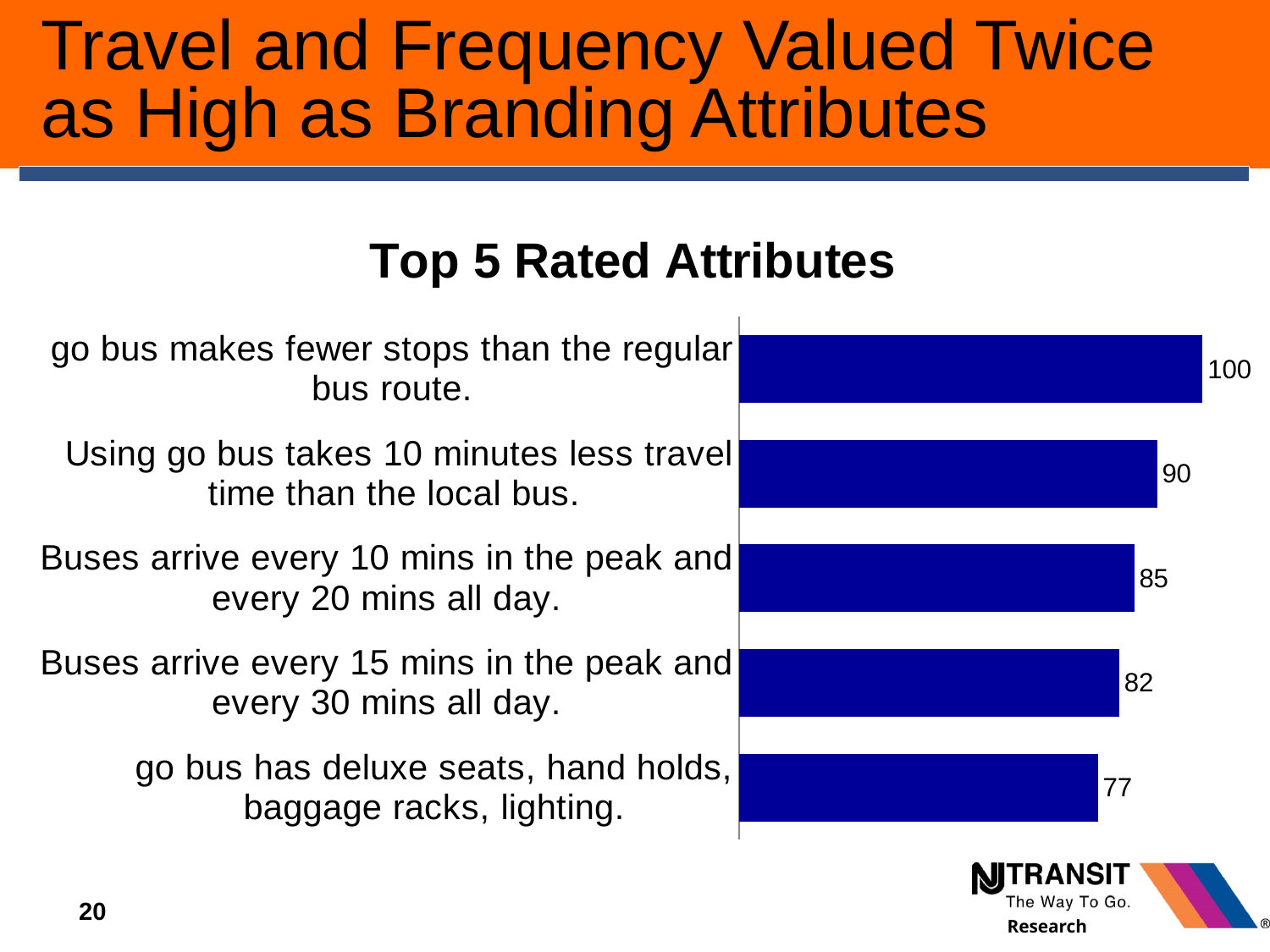
What is the value for "Using go bus takes 10 minutes less travel time than the local bus."? 90 Which attribute has the highest value? go bus makes fewer stops than the regular bus route. What is the title of the chart? Top 5 Rated Attributes What is the value for "Buses arrive every 10 mins in the peak and every 20 mins all day."? 85 What is the value for "go bus makes fewer stops than the regular bus route."? 100 What is the value for "go bus has deluxe seats, hand holds, baggage racks, lighting."? 77 Which has a larger value: "Using go bus takes 10 minutes less travel time than the local bus." or "Buses arrive every 15 mins in the peak and every 30 mins all day."? Using go bus takes 10 minutes less travel time than the local bus. What kind of chart is shown on the slide? bar chart How many attributes are shown in the chart? 5 Which attribute has the lowest value? go bus has deluxe seats, hand holds, baggage racks, lighting. What is the difference between the values for "Buses arrive every 10 mins in the peak and every 20 mins all day." and "Buses arrive every 15 mins in the peak and every 30 mins all day."? 3 What is the difference between the values for "go bus makes fewer stops than the regular bus route." and "go bus has deluxe seats, hand holds, baggage racks, lighting."? 23